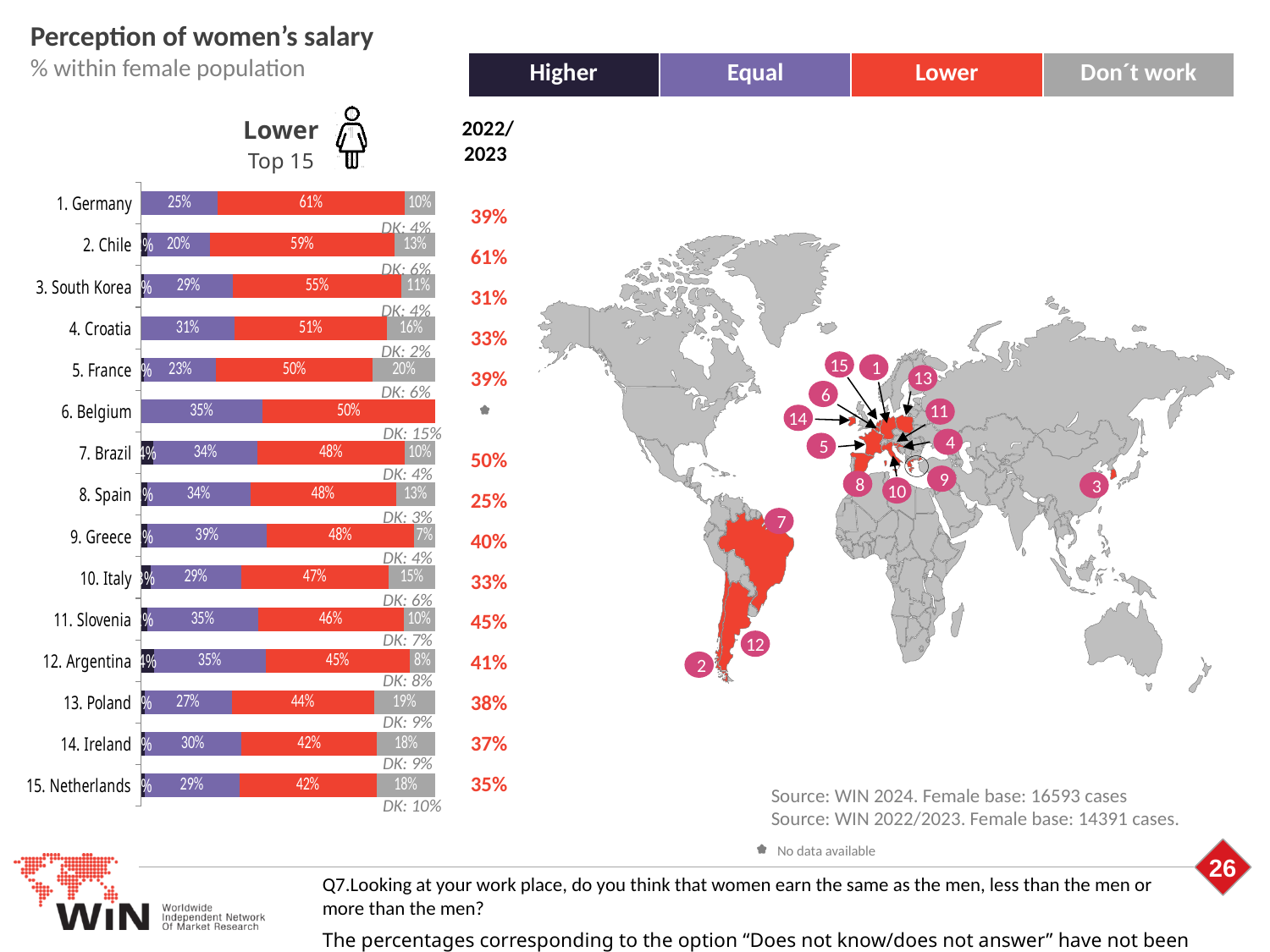
Which has a larger 'Equal' percentage, Croatia or France? Croatia Which colour represents the 'Lower' response in the legend? Red Which country has the highest 'Lower' percentage in the chart? Germany What is the difference between the 'Lower' percentages for Germany and Chile? 2% What kind of chart is used to show the perception of women's salary by country? Stacked bar chart How many countries are listed in the 'Lower Top 15' chart? 15 Which country has the highest 'Equal' percentage in the chart? Greece What was Chile's 'Lower' percentage in 2022/2023? 61% How many response categories does the legend list? 4 What percentage of women in Germany say their salary is lower than men's? 61% What is the 'Don't work' percentage for France? 20% What is the DK (don't know) percentage for Belgium? DK: 15%